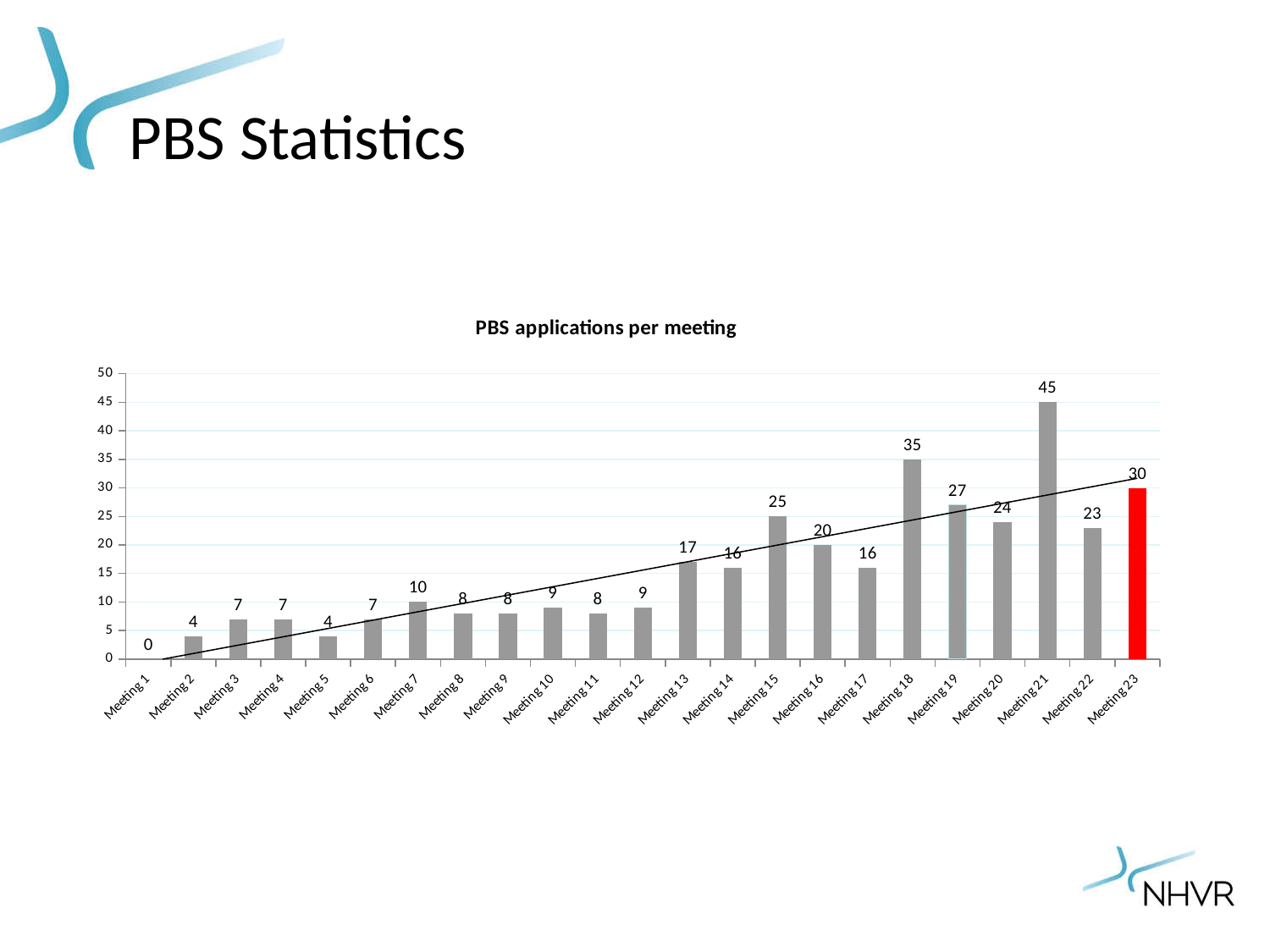
What kind of chart is shown? bar chart What is the value for Meeting 21? 45 Which meeting has the lowest number of PBS applications? Meeting 1 What is the value for Meeting 23? 30 What is the title of the chart? PBS applications per meeting What is the value for Meeting 18? 35 Is the value for Meeting 22 greater or less than 20? greater Which is larger, the value for Meeting 15 or the value for Meeting 19? Meeting 19 What is the difference between the values for Meeting 21 and Meeting 18? 10 Which meeting has the highest number of PBS applications? Meeting 21 Do the values generally rise or fall from Meeting 1 to Meeting 23? rise How many meetings are shown on the x axis? 23